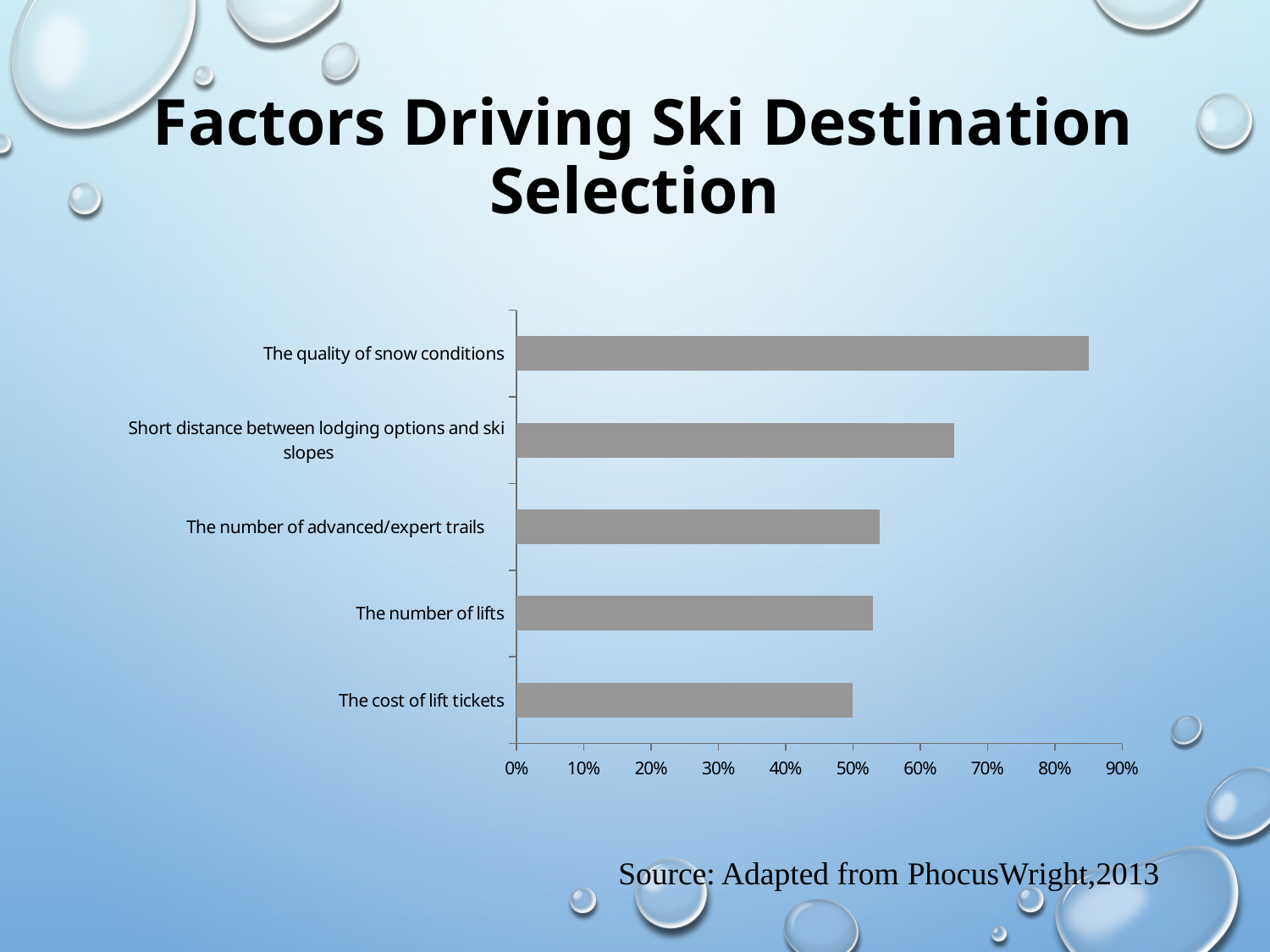
What is the title of the slide containing the chart? Factors Driving Ski Destination Selection Is the value for The cost of lift tickets greater or less than 60%? less What kind of chart is shown on the slide? bar chart How many factors (categories) are plotted in the chart? 5 Is the value for Short distance between lodging options and ski slopes greater or less than 60%? greater Which is larger: the value for The quality of snow conditions or the value for The cost of lift tickets? The quality of snow conditions Which factor has the highest value in the chart? The quality of snow conditions Which is larger: the value for Short distance between lodging options and ski slopes or the value for The number of advanced/expert trails? Short distance between lodging options and ski slopes Is the value for The number of advanced/expert trails greater or less than 60%? less